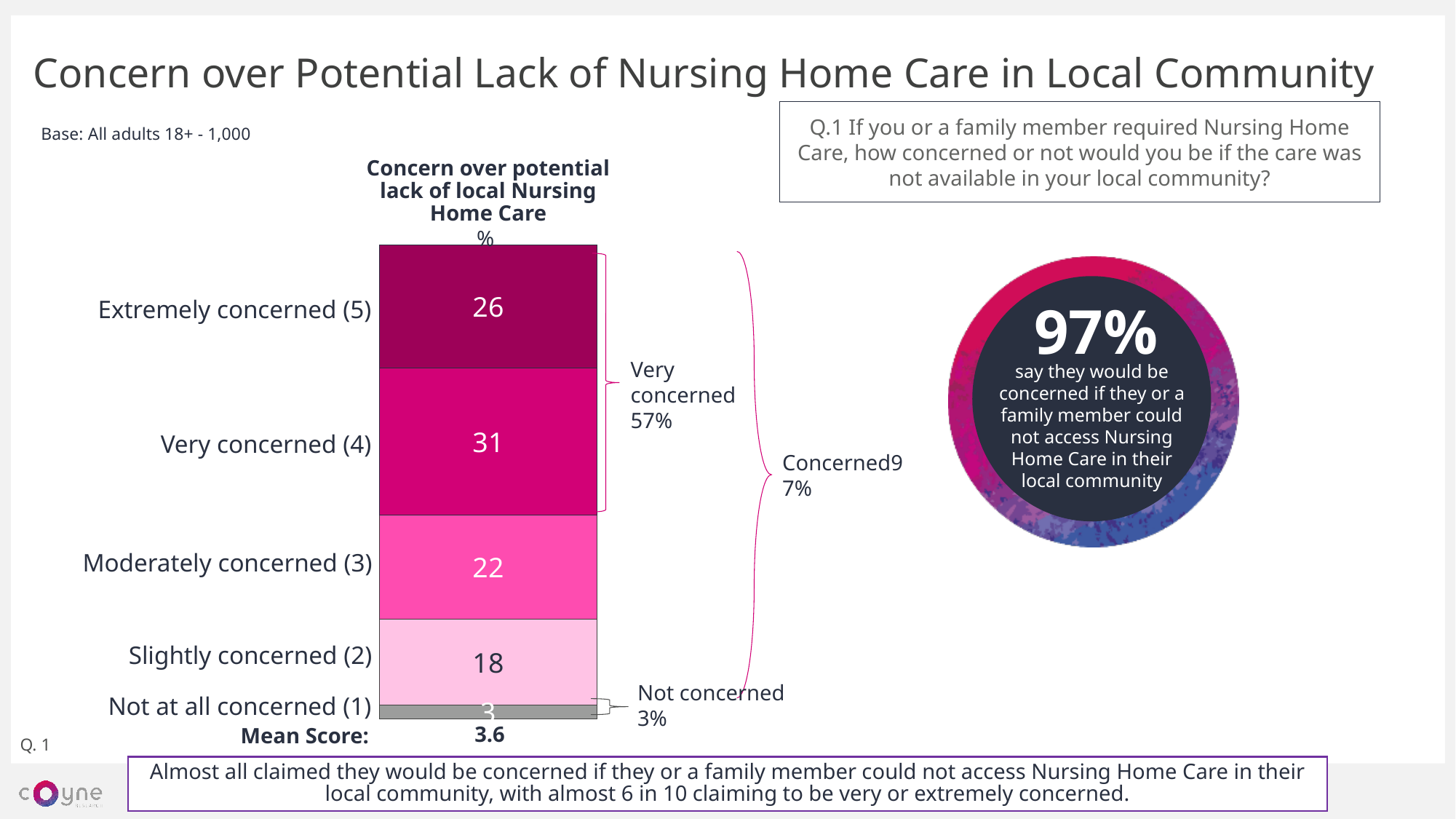
What kind of chart is shown on the slide? Stacked bar chart Which is larger: the share for Moderately concerned (3) or Slightly concerned (2)? Moderately concerned (3) How many concern levels are shown in the stacked bar? 5 What is the combined percentage for Extremely concerned (5) and Very concerned (4), as labelled on the bracket? 57% What percentage of respondents are Extremely concerned (5)? 26 What percentage is labelled as Not concerned? 3% What is the Mean Score shown below the chart? 3.6 What is the difference between the Very concerned (4) and Extremely concerned (5) percentages? 5 What percentage of respondents are Slightly concerned (2)? 18 Which concern level has the smallest share of respondents? Not at all concerned (1) What percentage of respondents are Very concerned (4)? 31 Which concern level has the largest share of respondents? Very concerned (4)